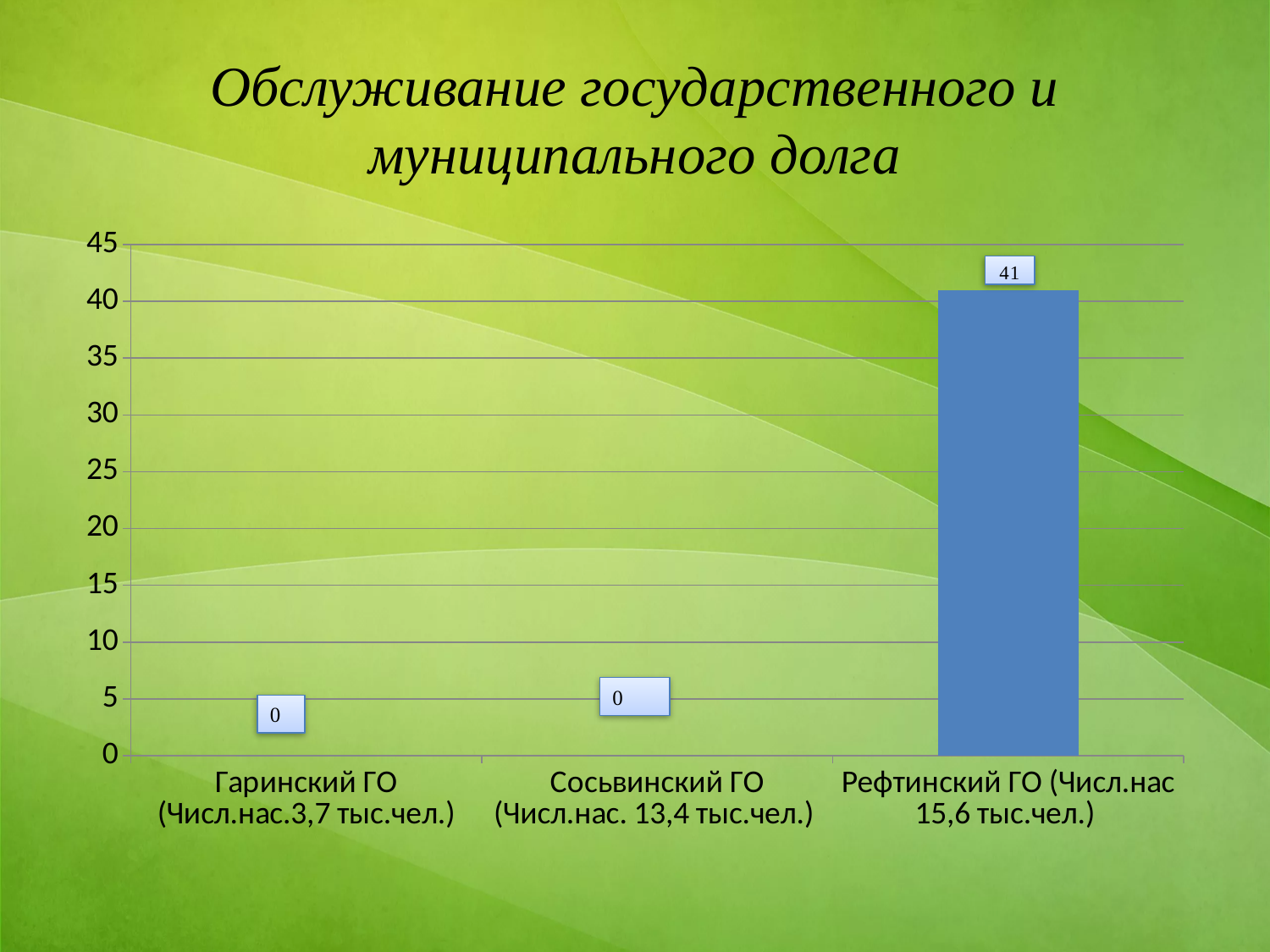
Is the value for Рефтинский ГО greater or less than 40? greater Which category has the highest value? Рефтинский ГО What kind of chart is shown on the slide? bar chart What is the value for Сосьвинский ГО? 0 Which is larger, the value for Рефтинский ГО or the value for Гаринский ГО? Рефтинский ГО What is the title of the slide? Обслуживание государственного и муниципального долга How many categories are shown on the x axis? 3 What is the highest value shown on the vertical axis? 45 What is the value for Рефтинский ГО? 41 How many categories have a value of 0? 2 What is the value for Гаринский ГО? 0 What is the difference between the values for Рефтинский ГО and Сосьвинский ГО? 41